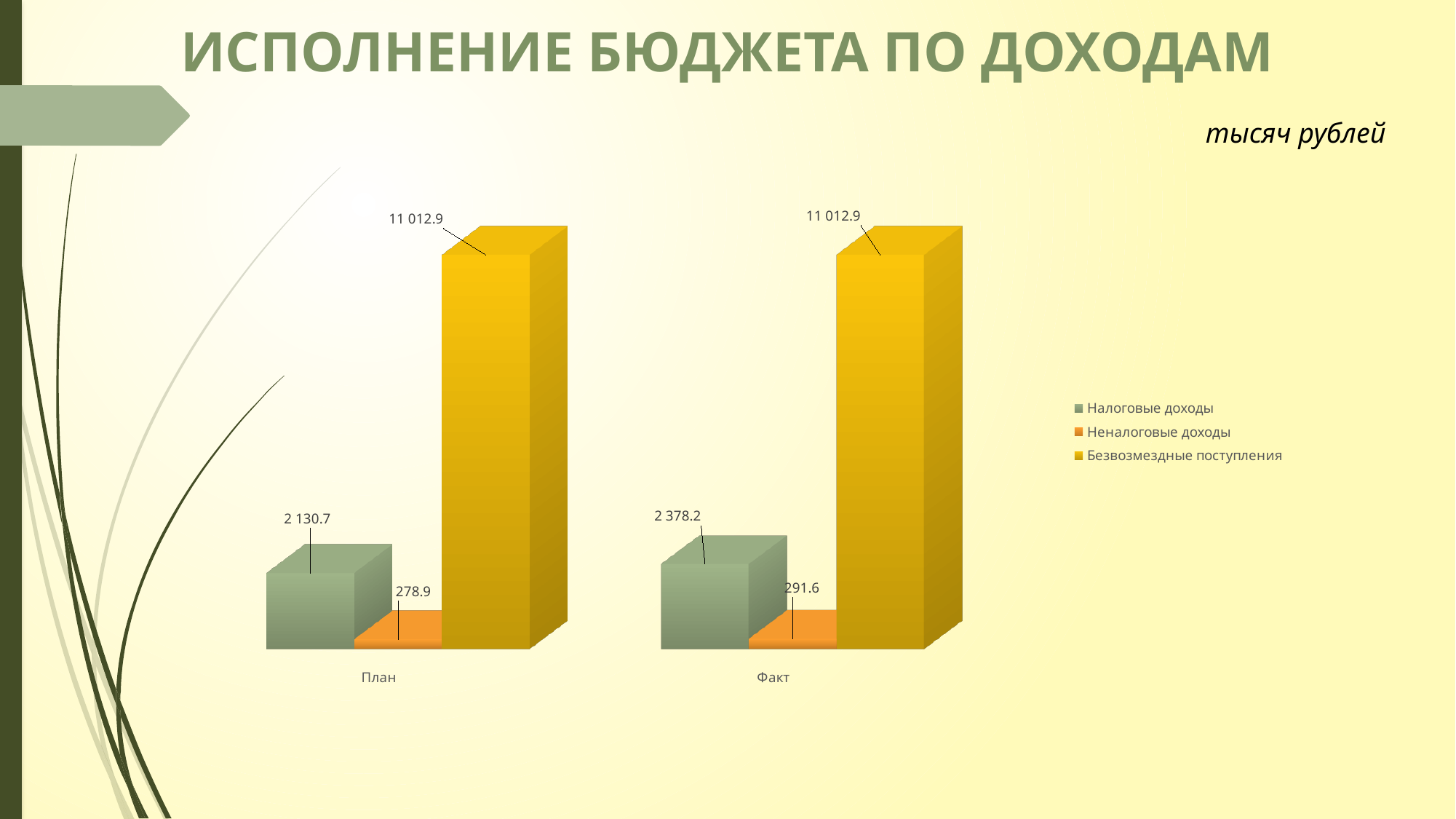
Which series has the highest value for План? Безвозмездные поступления What is the value of Неналоговые доходы for План? 278.9 What is the value of Неналоговые доходы for Факт? 291.6 What is the difference between Неналоговые доходы for Факт and for План? 12.7 How many categories are shown on the x axis? 2 What is the value of Безвозмездные поступления for Факт? 11 012.9 What is the difference between Налоговые доходы for Факт and for План? 247.5 What is the value of Налоговые доходы for План? 2 130.7 How many series does the legend list? 3 What kind of chart is shown on the slide? Bar chart Which is larger: Налоговые доходы for План or Налоговые доходы for Факт? Факт Which series has the lowest value for Факт? Неналоговые доходы